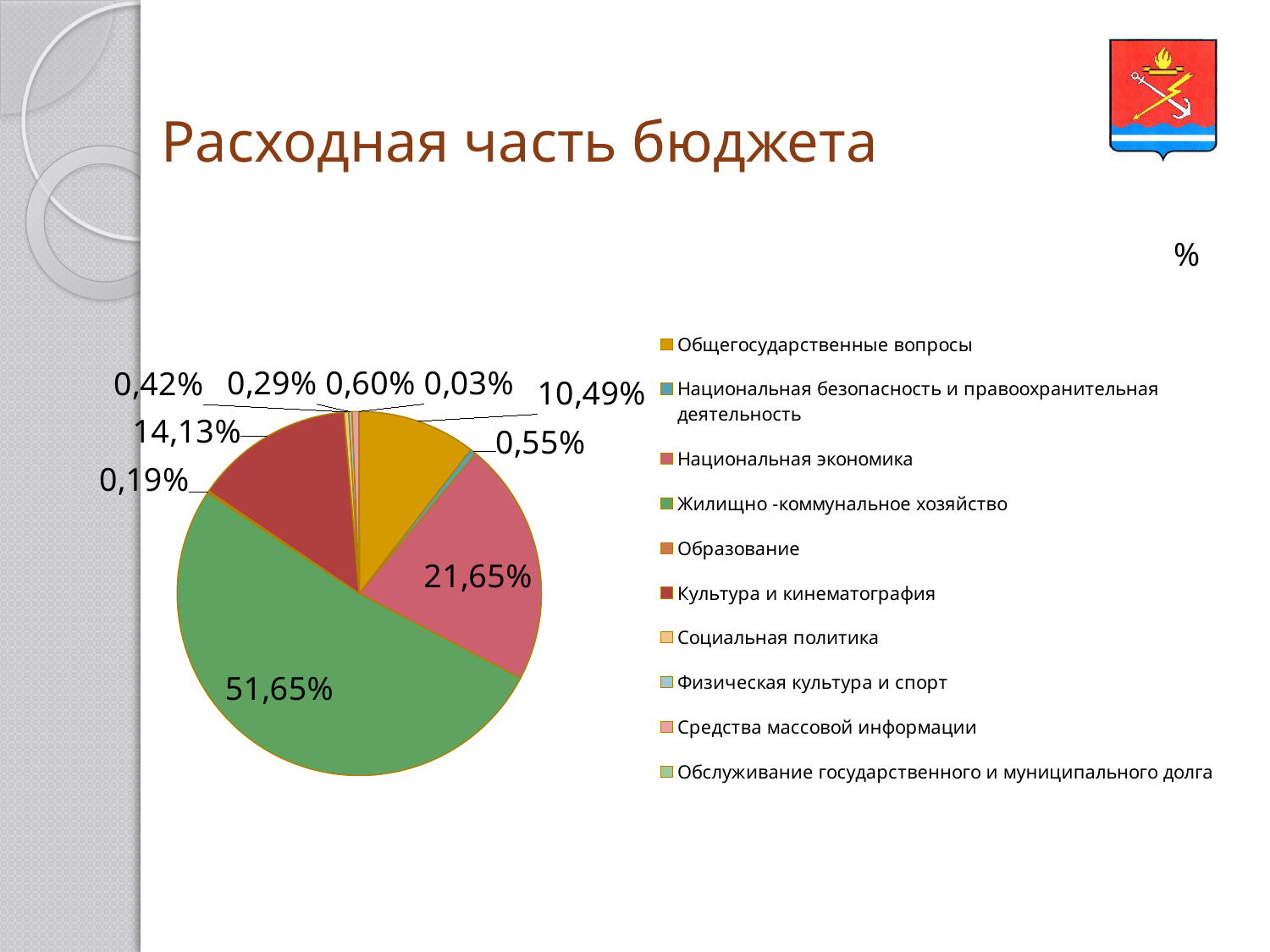
How many categories does the legend of the pie chart list? 10 Which is larger: the share of Культура и кинематография or the share of Общегосударственные вопросы? Культура и кинематография What is the share of Национальная экономика? 21,65% What is the share of Жилищно-коммунальное хозяйство? 51,65% What type of chart is shown on the slide? pie chart Which category has the largest share of the pie? Жилищно-коммунальное хозяйство What colour is the slice for Жилищно-коммунальное хозяйство? green What is the title of the chart on the slide? Расходная часть бюджета What is the difference between the share of Жилищно-коммунальное хозяйство and the share of Национальная экономика? 30,00% What is the smallest share shown on the pie chart? 0,03% What is the share of Культура и кинематография? 14,13% What is the share of Общегосударственные вопросы? 10,49%